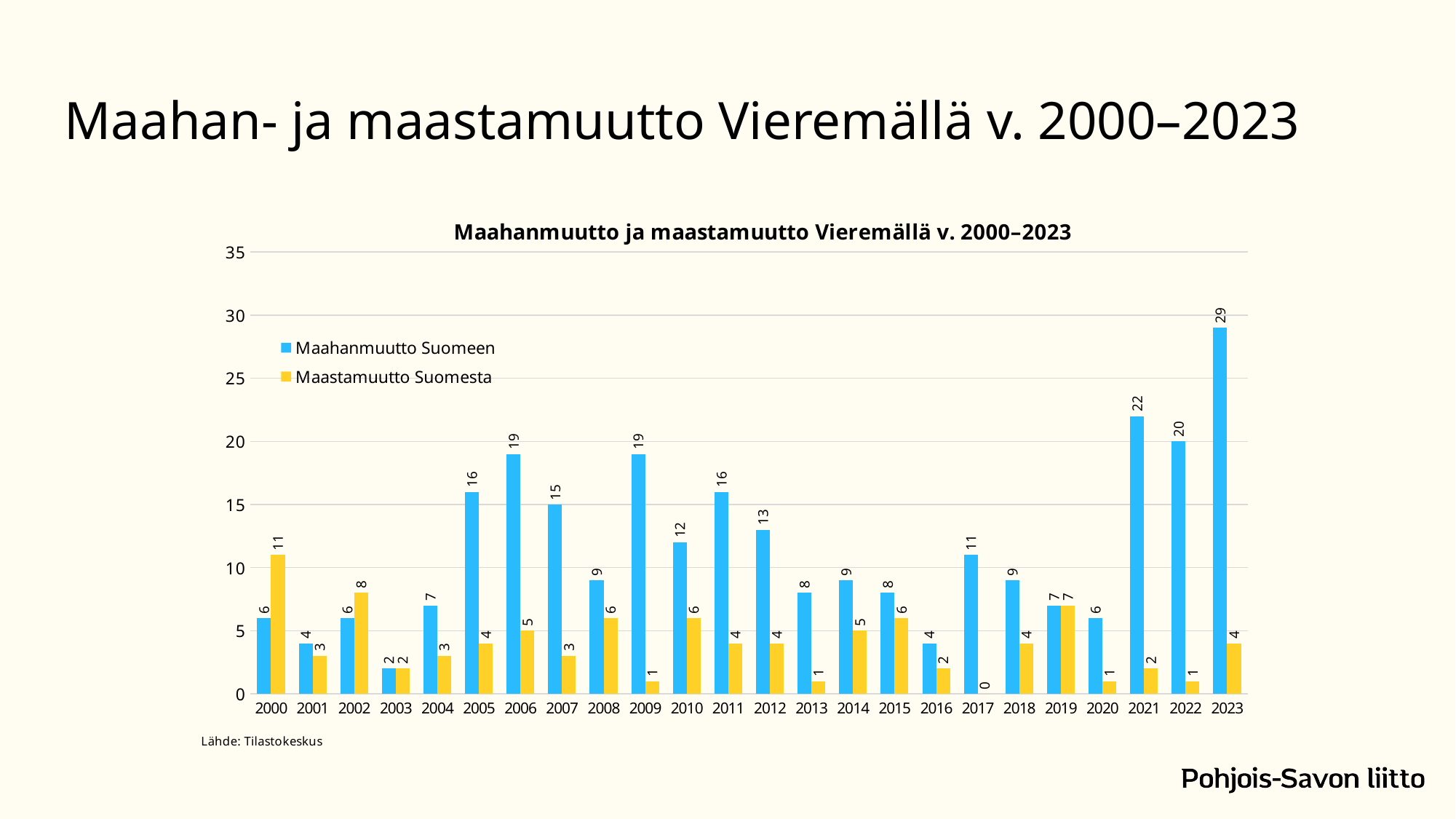
What is the value of Maahanmuutto Suomeen in 2009? 19 In which year is Maastamuutto Suomesta lowest? 2017 What is the value of Maastamuutto Suomesta in 2000? 11 In which year is Maastamuutto Suomesta highest? 2000 How many series does the legend list? 2 In which year is Maahanmuutto Suomeen highest? 2023 Which is larger in 2002: Maahanmuutto Suomeen or Maastamuutto Suomesta? Maastamuutto Suomesta What is the value of Maahanmuutto Suomeen in 2023? 29 What is the difference between Maahanmuutto Suomeen and Maastamuutto Suomesta in 2021? 20 What is the title of the chart? Maahanmuutto ja maastamuutto Vieremällä v. 2000–2023 How many years are shown on the x axis? 24 What kind of chart is shown on the slide? Bar chart